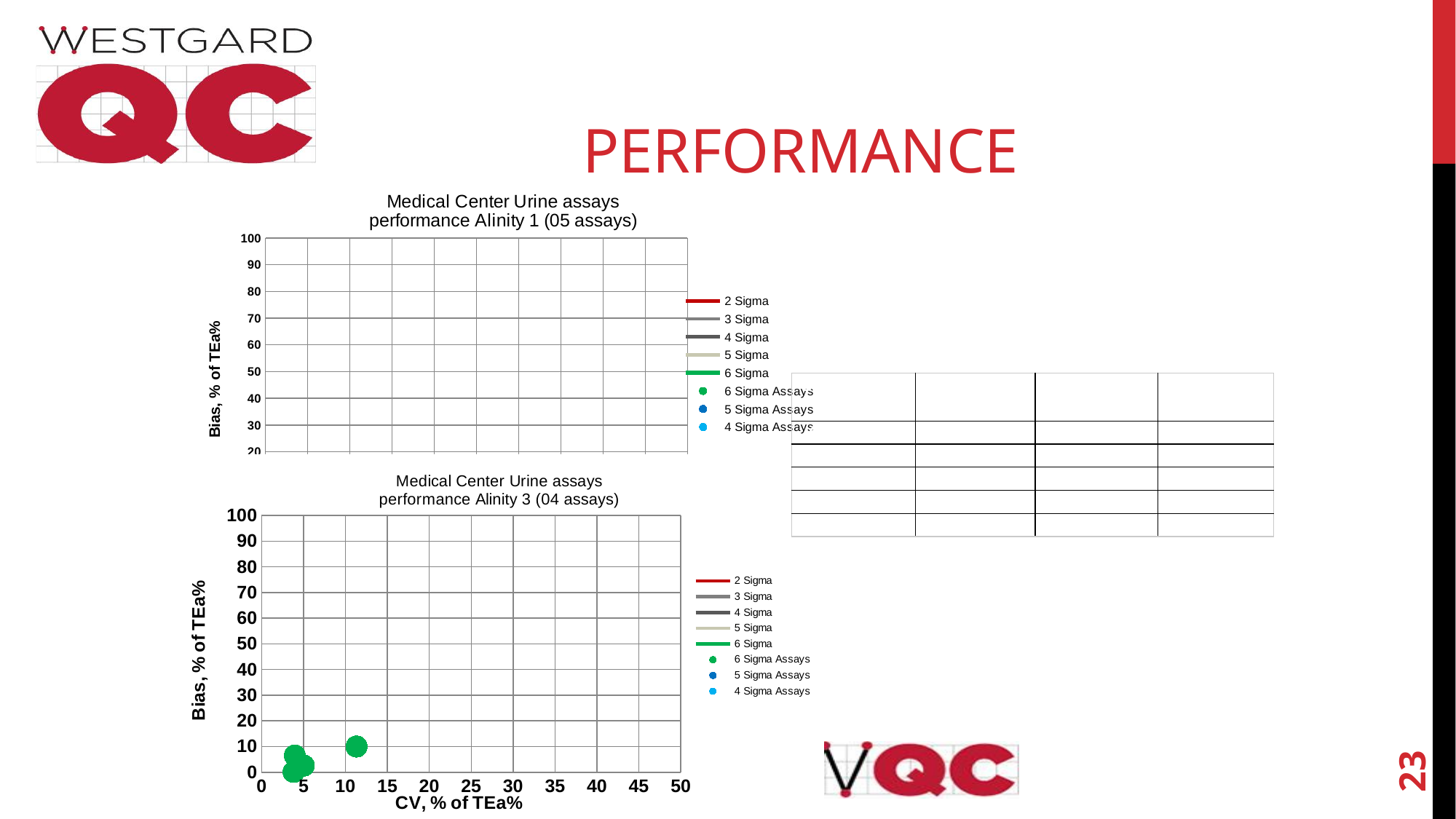
How many entries does the legend of the top chart (Alinity 1) list? 8 What is the maximum value shown on the y axis of the bottom chart (Alinity 3)? 100 In the bottom chart (Alinity 3), is the bias value of the rightmost plotted point greater or less than 20? less In the bottom chart (Alinity 3), are all plotted points' CV values greater or less than 15? less In the bottom chart (Alinity 3), which legend series do the green plotted points belong to? 6 Sigma Assays In the bottom chart (Alinity 3), is the CV value of the rightmost plotted point greater or less than 20? less In the bottom chart (Alinity 3), what is the y-axis title? Bias, % of TEa% What kind of chart is the bottom chart, 'Medical Center Urine assays performance Alinity 3 (04 assays)'? Scatter chart How many entries does the legend of the bottom chart (Alinity 3) list? 8